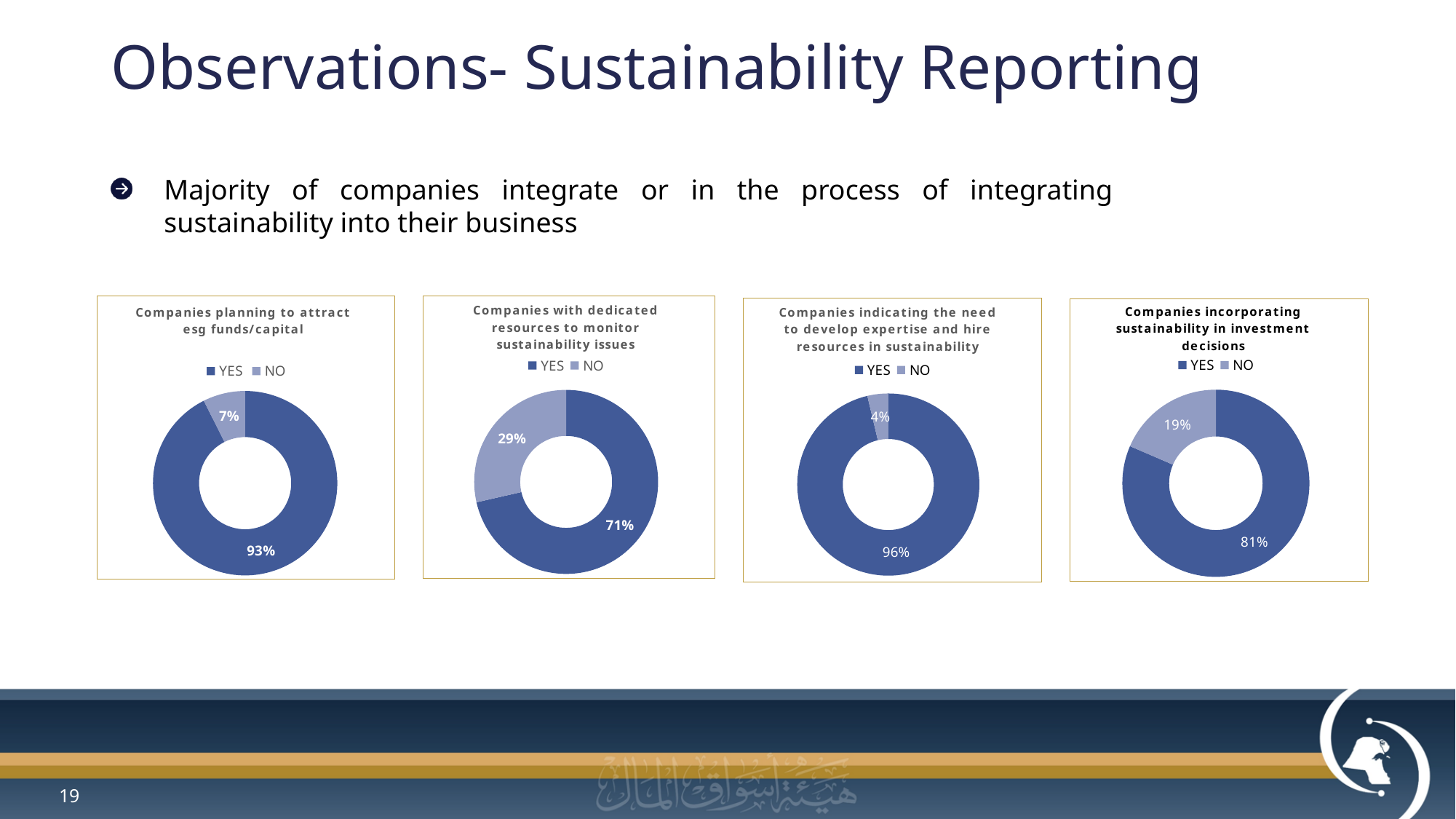
In the chart titled 'Companies indicating the need to develop expertise and hire resources in sustainability', which answer has the smallest share? NO In the chart titled 'Companies indicating the need to develop expertise and hire resources in sustainability', what percentage answered YES? 96% What kind of chart is used in the chart titled 'Companies planning to attract esg funds/capital'? Doughnut chart In the chart titled 'Companies incorporating sustainability in investment decisions', which answer has the larger share, YES or NO? YES How many entries does the legend list in the chart titled 'Companies with dedicated resources to monitor sustainability issues'? 2 In the chart titled 'Companies with dedicated resources to monitor sustainability issues', what percentage answered NO? 29% In the chart titled 'Companies planning to attract esg funds/capital', what percentage answered YES? 93% In the chart titled 'Companies incorporating sustainability in investment decisions', what is the total of the YES and NO shares? 100% In the chart titled 'Companies with dedicated resources to monitor sustainability issues', what is the difference between the YES and NO shares? 42% In the chart titled 'Companies incorporating sustainability in investment decisions', what percentage answered NO? 19% In the chart titled 'Companies planning to attract esg funds/capital', what percentage answered NO? 7% How many charts are shown on the slide? 4